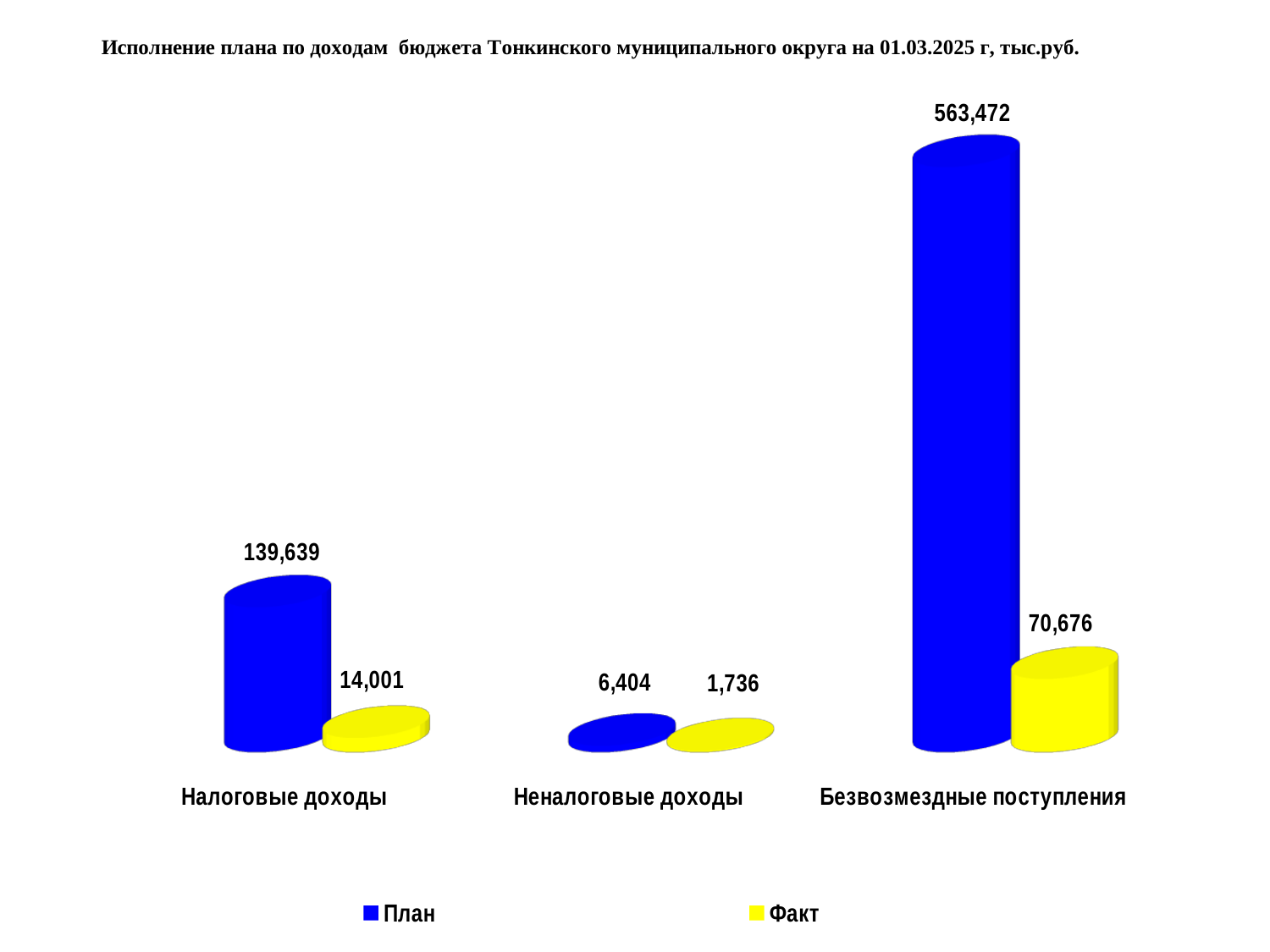
What is the difference between the План and Факт values for Налоговые доходы? 125,638 Which is larger: the Факт value for Налоговые доходы or the Факт value for Безвозмездные поступления? Безвозмездные поступления What is the План value for Налоговые доходы? 139,639 What is the План value for Неналоговые доходы? 6,404 Which category has the highest План value? Безвозмездные поступления What is the Факт value for Неналоговые доходы? 1,736 How many categories are shown on the x axis? 3 What is the Факт value for Безвозмездные поступления? 70,676 Which category has the lowest Факт value? Неналоговые доходы What is the difference between the План and Факт values for Безвозмездные поступления? 492,796 What kind of chart is shown on the slide? Bar chart How many series does the legend list? 2